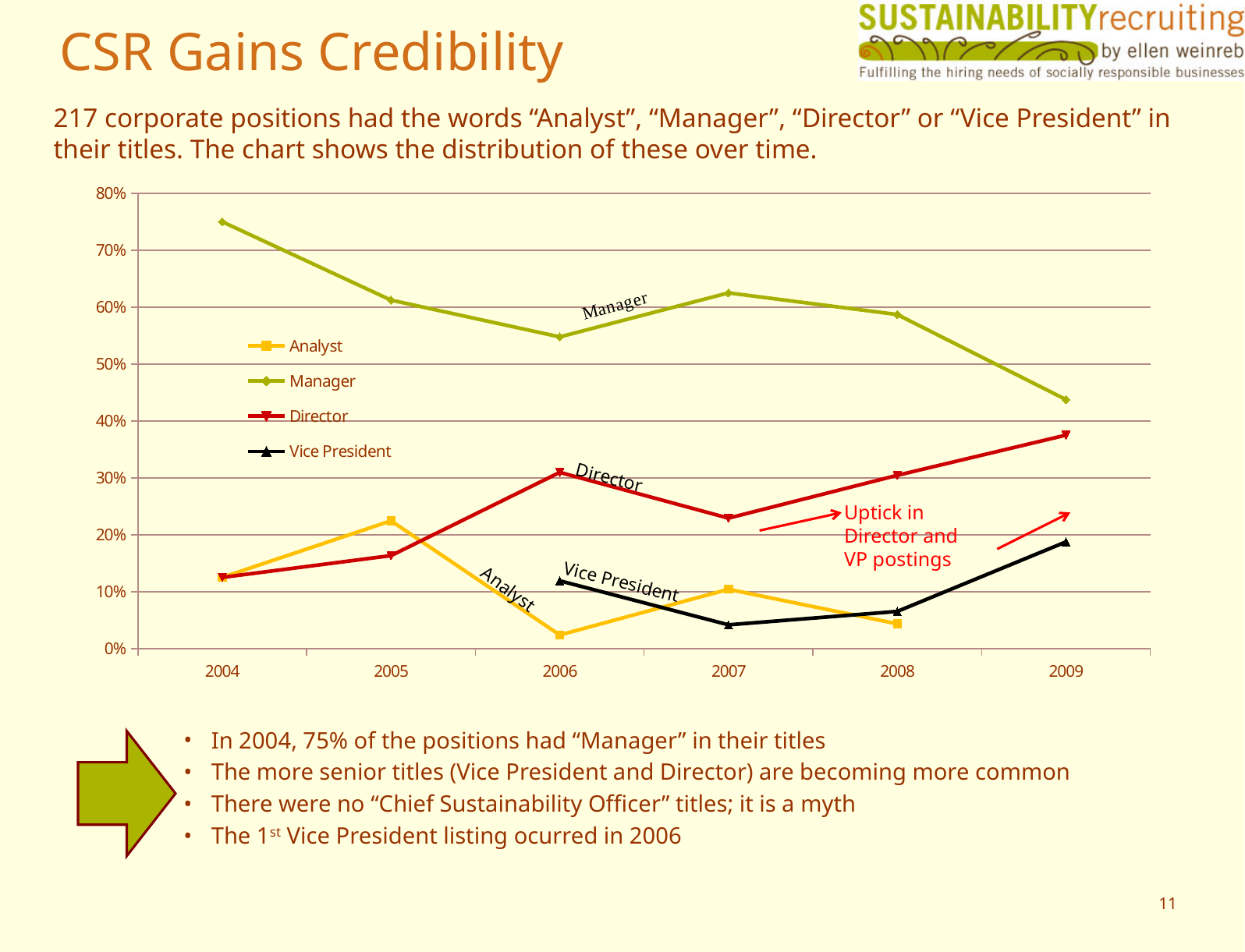
Does the Manager series rise or fall overall from 2004 to 2009? fall Which series has the lowest value in 2009? Vice President How many years are shown on the x axis of the chart? 6 Which series is drawn in black on the chart? Vice President Is the Manager value for 2009 greater or less than 40%? greater What kind of chart is shown on the slide? line chart How many series does the chart legend list? 4 What percentage of positions had "Manager" in their titles in 2004? 75% In 2009, which is larger: the Manager value or the Director value? Manager Is the Vice President value for 2007 greater or less than 10%? less Is the Analyst value for 2006 greater or less than 10%? less Which series has the highest value in 2004? Manager